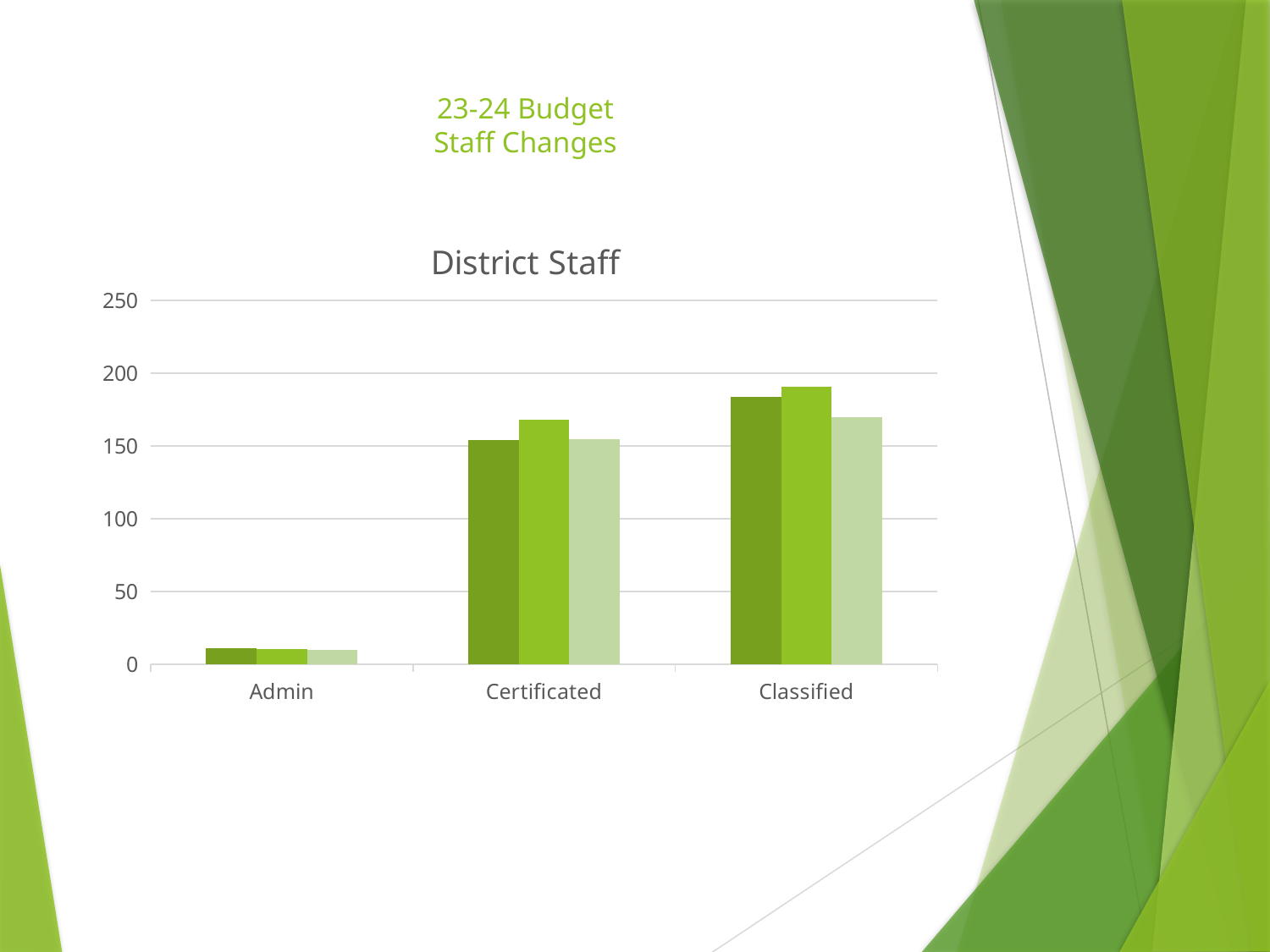
Do the values rise or fall moving from Admin to Classified along the x axis? rise Are the values for Classified greater or less than 200? less How many bars are plotted for each category in the District Staff chart? 3 Are the values for Admin greater or less than 50? less What is the title of the chart? District Staff Are the values for Certificated greater or less than 100? greater What kind of chart is shown on the slide? bar chart Which category has the highest bars in the District Staff chart? Classified How many categories are shown on the x axis of the District Staff chart? 3 Which category has larger values, Certificated or Classified? Classified Which category has the lowest bars in the District Staff chart? Admin